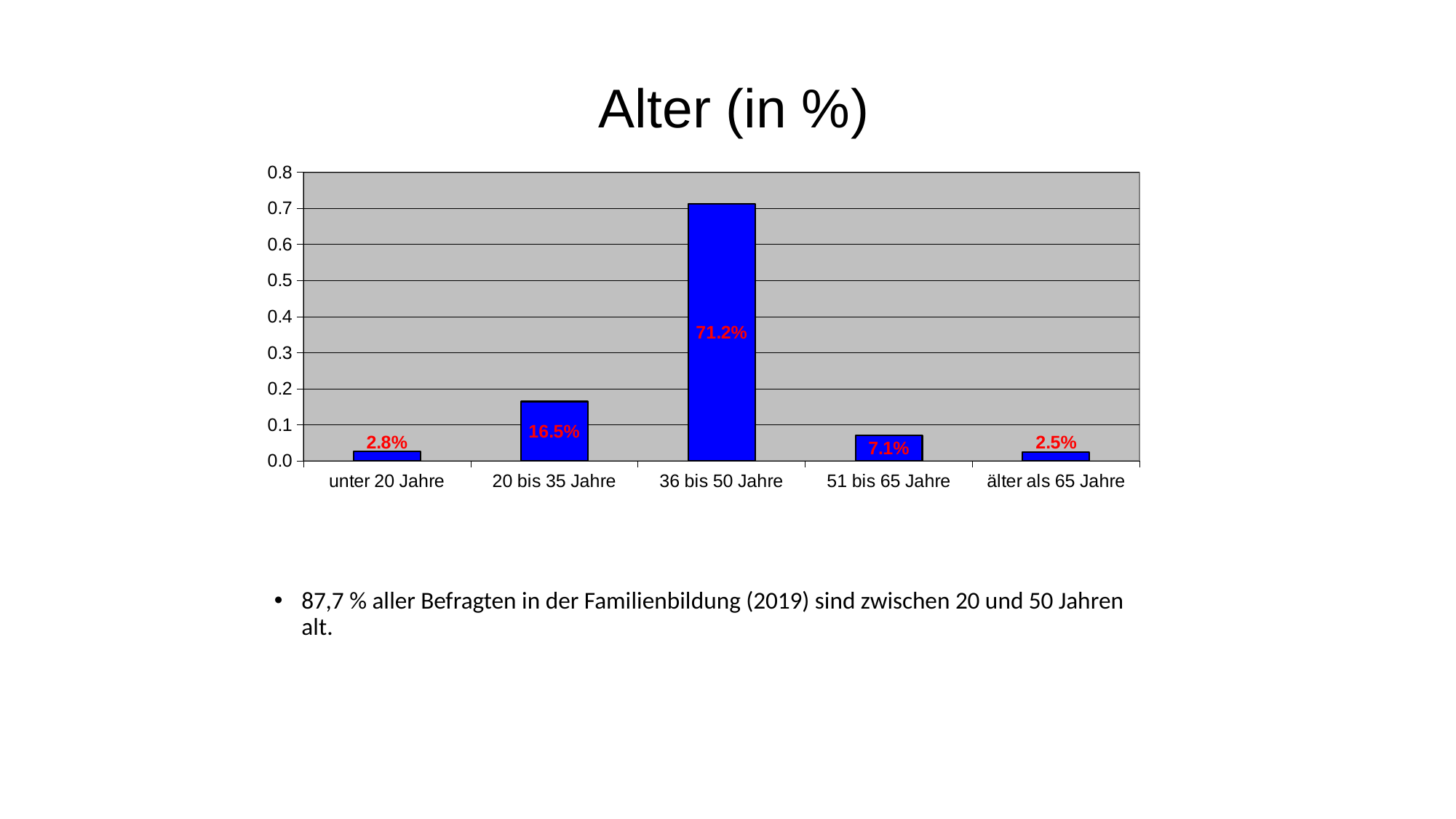
Which category has the lowest value? älter als 65 Jahre Which category has the highest value? 36 bis 50 Jahre Is the bar for '36 bis 50 Jahre' greater or less than 0.6 on the axis? greater What is the value for the '36 bis 50 Jahre' category? 71.2% What is the difference between the values for '20 bis 35 Jahre' and '51 bis 65 Jahre'? 9.4% Which is larger, the value for '20 bis 35 Jahre' or the value for '51 bis 65 Jahre'? 20 bis 35 Jahre What is the value for the 'unter 20 Jahre' category? 2.8% What kind of chart is shown on the slide? Bar chart What is the title of the chart? Alter (in %) What is the value for the 'älter als 65 Jahre' category? 2.5% What is the value for the '20 bis 35 Jahre' category? 16.5% How many age categories are shown on the x axis? 5